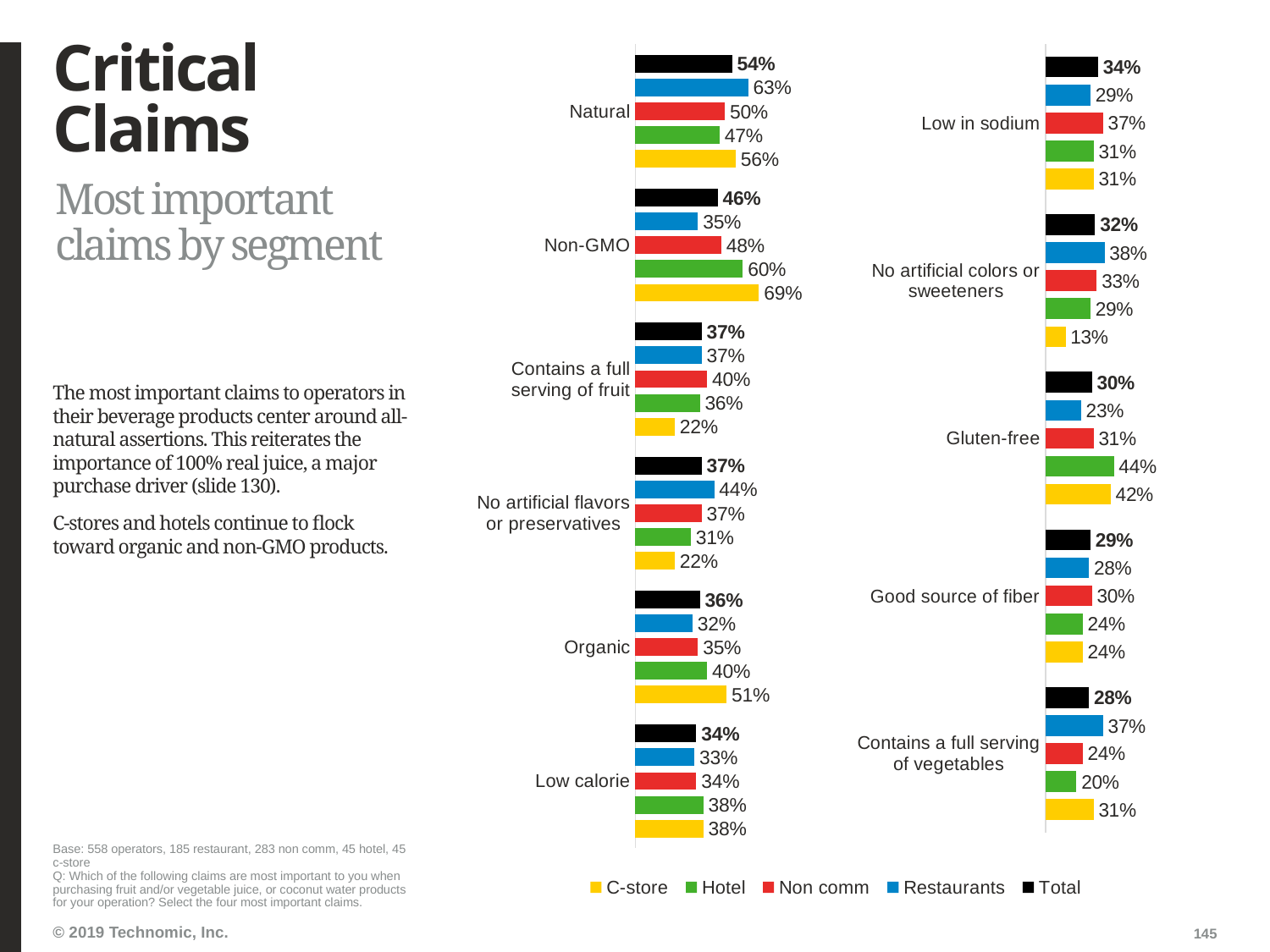
On the right chart, which category has the lowest Total value? Contains a full serving of vegetables On the right chart, which is larger for Contains a full serving of vegetables: the Restaurants value or the Hotel value? Restaurants How many series does the legend list? 5 On the right chart, what is the Hotel value for Gluten-free? 44% On the left chart, what is the C-store value for Non-GMO? 69% Which colour represents the Hotel series in the legend? Green What kind of chart is used on this slide? Bar chart On the left chart, what is the difference between the C-store and Restaurants values for Non-GMO? 34% On the right chart, what is the C-store value for No artificial colors or sweeteners? 13% On the left chart, what is the Restaurants value for Natural? 63% On the left chart, which category has the highest Total value? Natural How many categories are shown on the left chart? 6